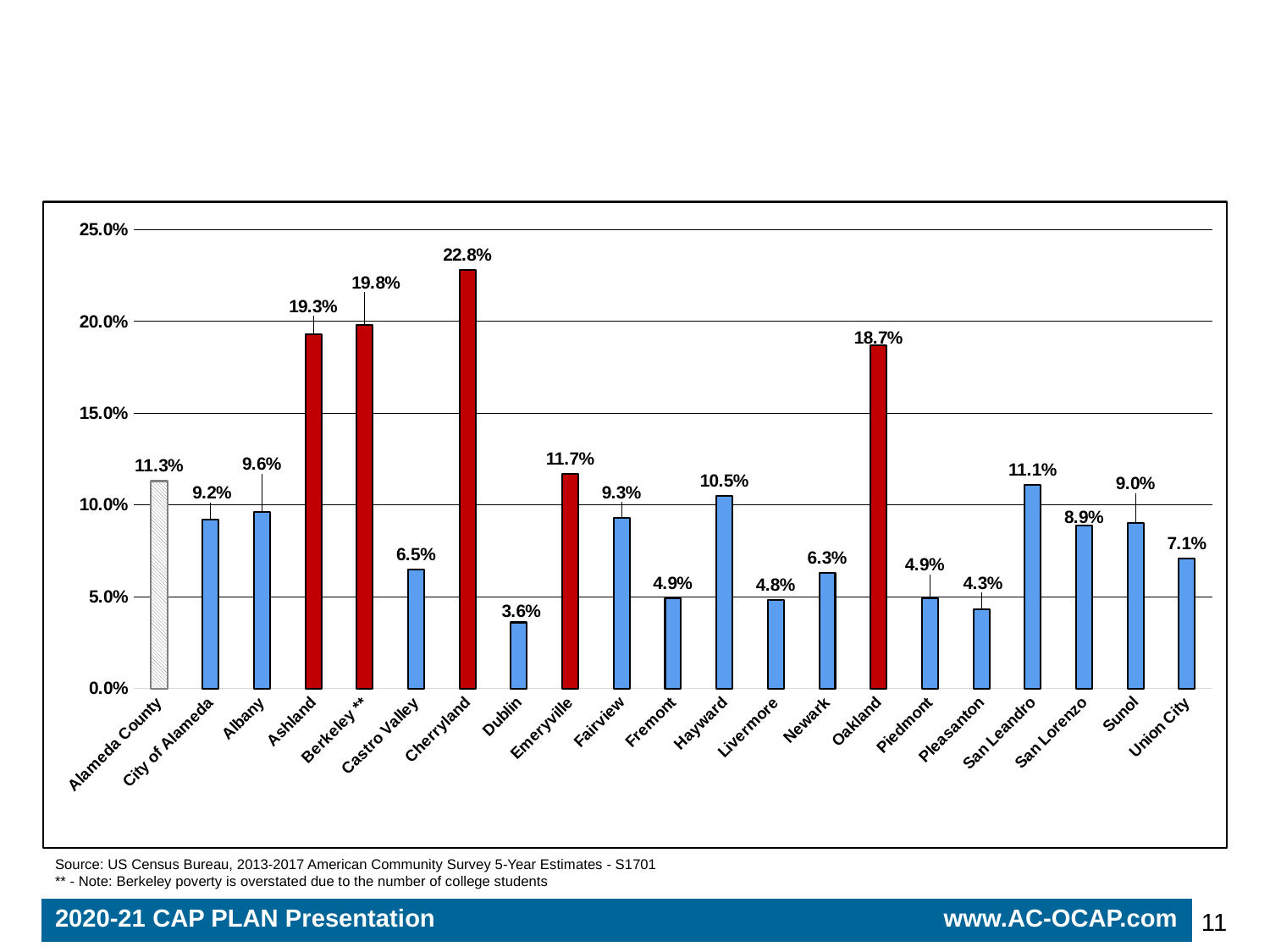
What is the value shown for Cherryland? 22.8% What is the value shown for Pleasanton? 4.3% What is the difference between the values for Berkeley ** and Ashland? 0.5% What is the value shown for Oakland? 18.7% What kind of chart is shown on the slide? Bar chart How many categories are shown on the x axis? 21 Which category has the lowest value? Dublin Which category has the highest value? Cherryland What is the value shown for Alameda County? 11.3% Which is larger, the value for Hayward or the value for San Leandro? San Leandro How many bars are coloured red? 5 What is the difference between the values for Cherryland and Oakland? 4.1%